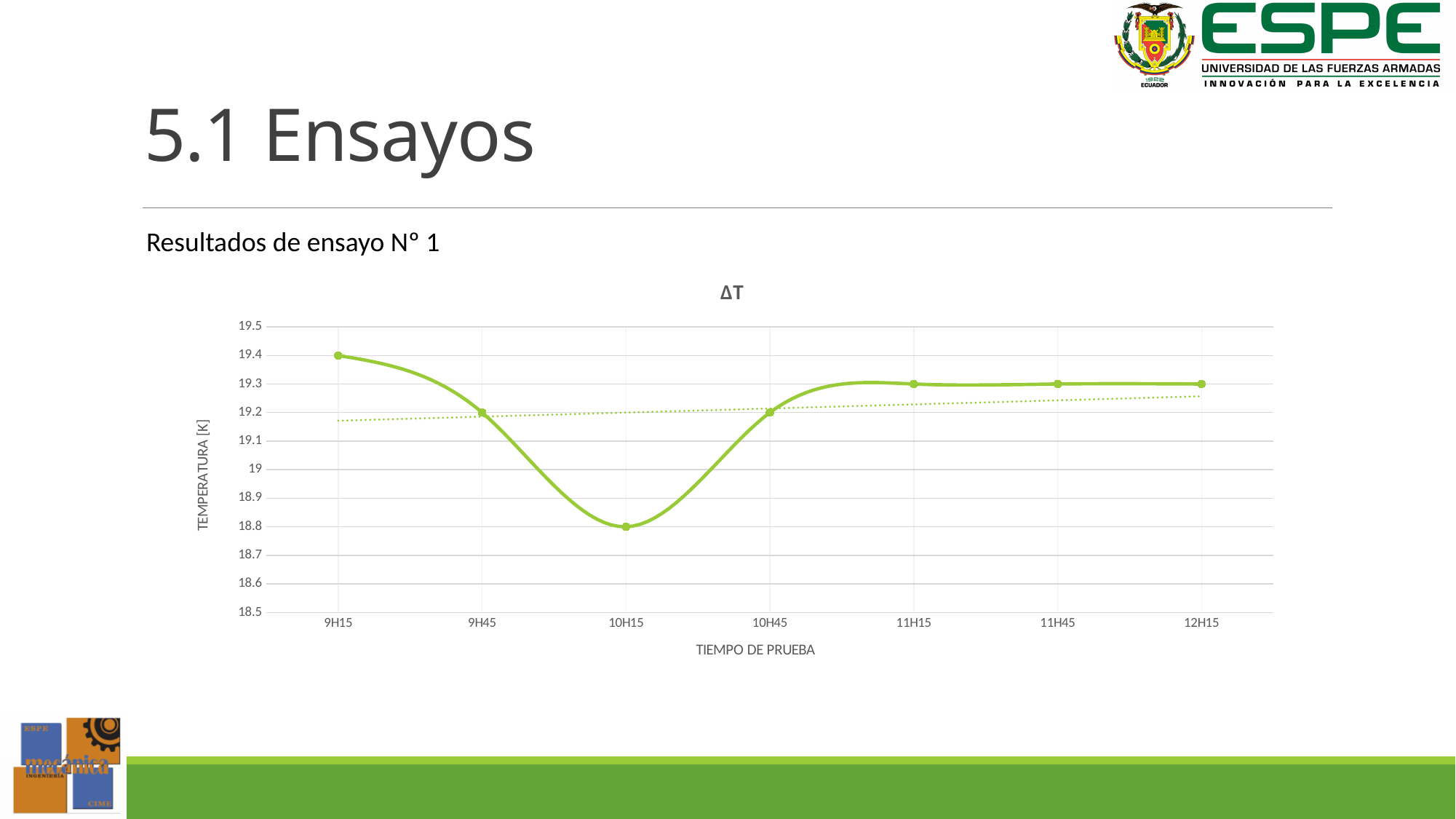
What kind of chart is shown on the slide? Line chart What is the difference between the temperature at 9H15 and at 10H15 in the ΔT chart? 0.6 At which time point is the temperature lowest in the ΔT chart? 10H15 At which time point is the temperature highest in the ΔT chart? 9H15 What is the temperature value at 12H15 in the ΔT chart? 19.3 Which has the larger temperature value in the ΔT chart, 9H45 or 11H15? 11H15 What is the temperature value at 9H15 in the ΔT chart? 19.4 How many time points are plotted on the x axis of the ΔT chart? 7 What is the temperature value at 10H45 in the ΔT chart? 19.2 What is the label of the y axis in the ΔT chart? TEMPERATURA [K] What is the temperature value at 10H15 in the ΔT chart? 18.8 Is the temperature value at 10H15 greater or less than 19? less